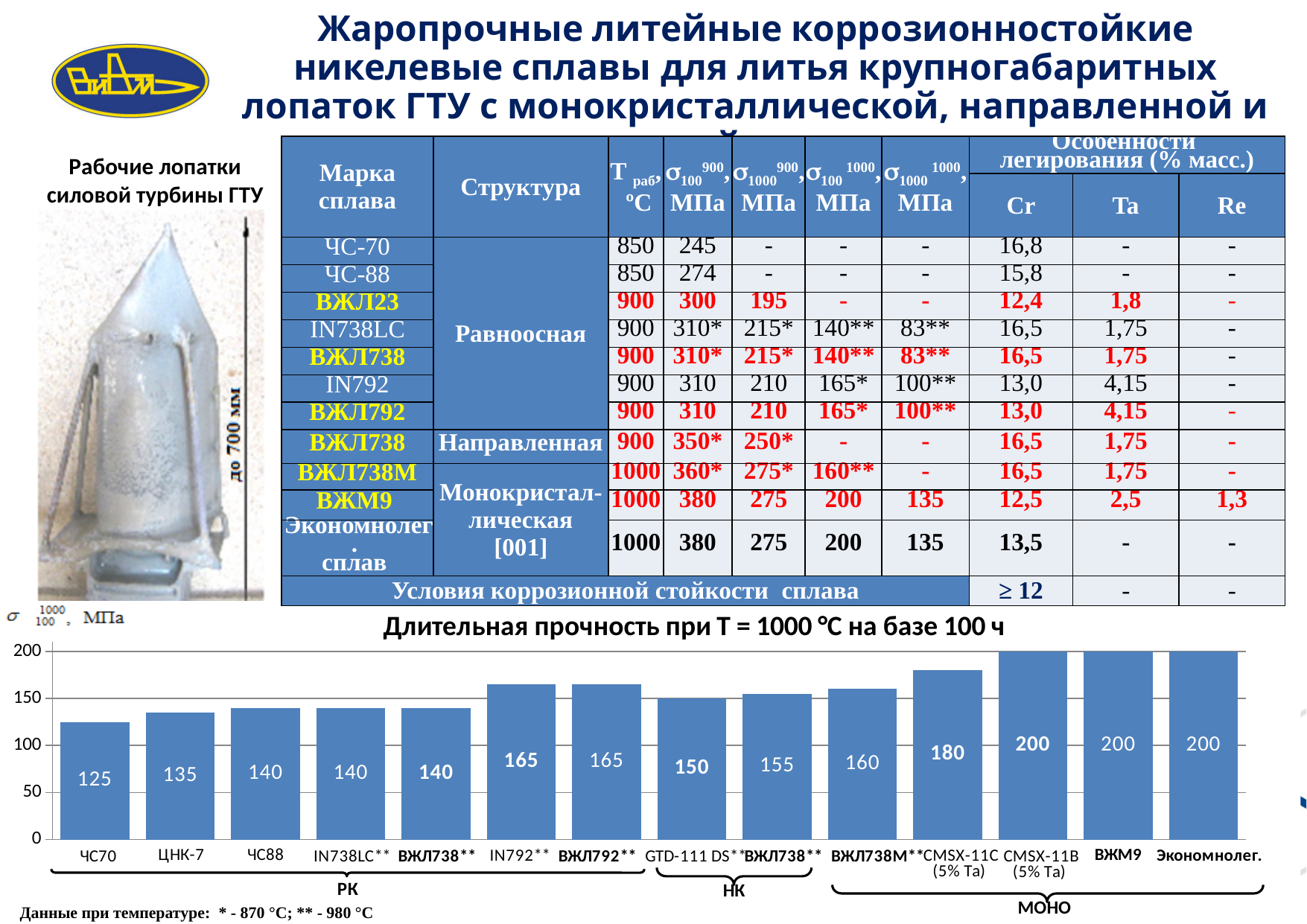
Which is larger in the chart, the value for IN792** or the value for GTD-111 DS**? IN792** What value do ВЖМ9, CMSX-11B (5% Ta) and Экономнолег. all share in the chart? 200 What is the value for ЦНК-7 in the chart? 135 How many bars are plotted in the chart? 14 What is the value for ЧС70 in the chart? 125 What is the value for CMSX-11C (5% Ta) in the chart? 180 Which category has the lowest value in the chart? ЧС70 What is the title of the chart at the bottom of the slide? Длительная прочность при Т = 1000 °С на базе 100 ч What type of chart is shown at the bottom of the slide? bar chart What is the value for ВЖЛ738М** in the chart? 160 What is the difference between the values for ВЖМ9 and ЧС70 in the chart? 75 What is the difference between the values for CMSX-11C (5% Ta) and ЦНК-7 in the chart? 45